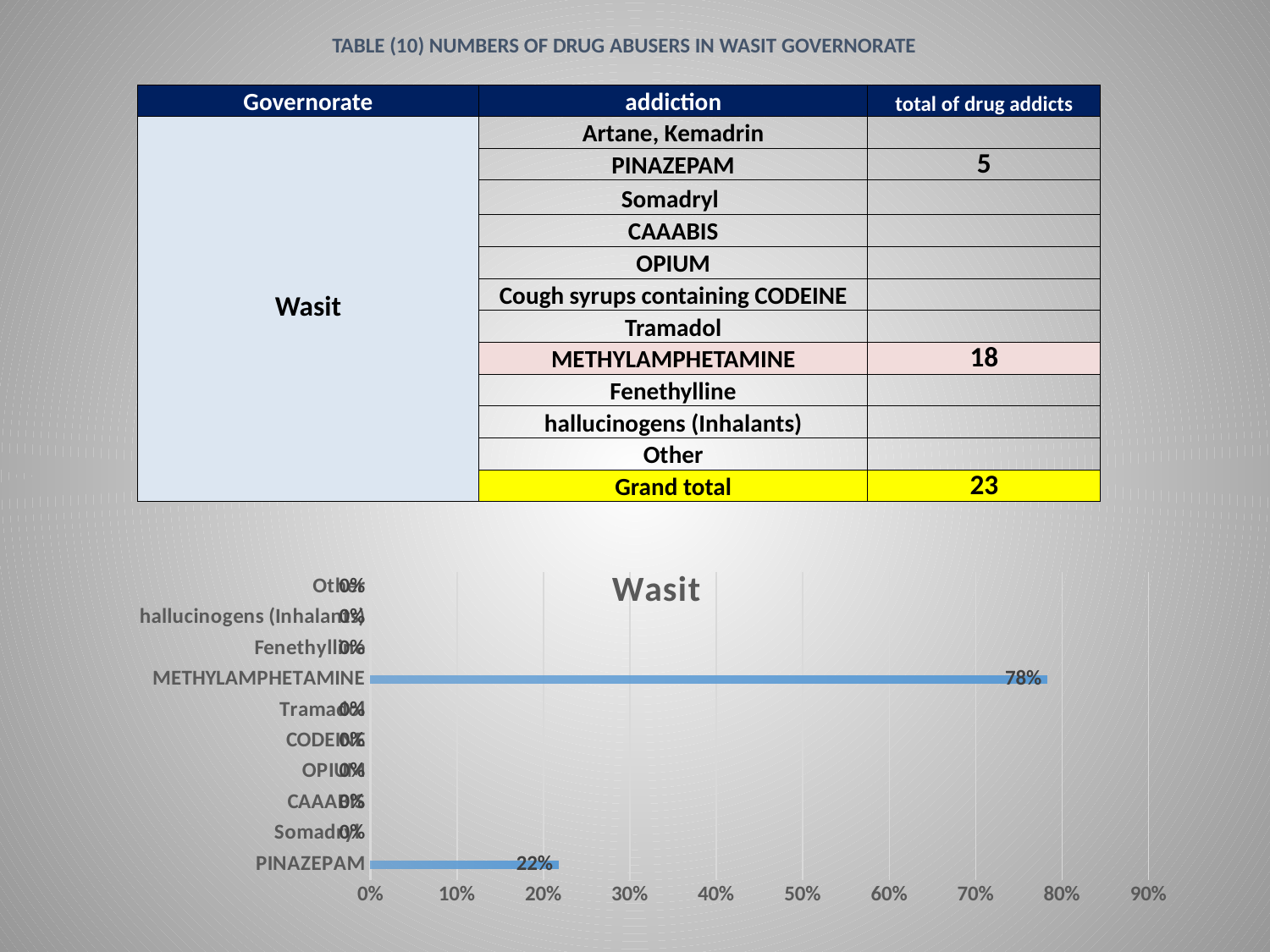
What is the value for Fenethylline in the chart? 0% What is the value for PINAZEPAM in the chart? 22% Which category has the highest value in the chart? METHYLAMPHETAMINE What is the difference between the values for METHYLAMPHETAMINE and PINAZEPAM in the chart? 56% What is the value for METHYLAMPHETAMINE in the chart? 78% Is the value for PINAZEPAM in the chart greater or less than 30%? less What is the title of the chart? Wasit What type of chart is shown on the slide? bar chart Is the value for METHYLAMPHETAMINE in the chart greater or less than 70%? greater How many categories are shown on the chart's vertical axis? 10 What is the highest value shown on the chart's horizontal axis? 90% Which is larger in the chart, the value for METHYLAMPHETAMINE or the value for PINAZEPAM? METHYLAMPHETAMINE